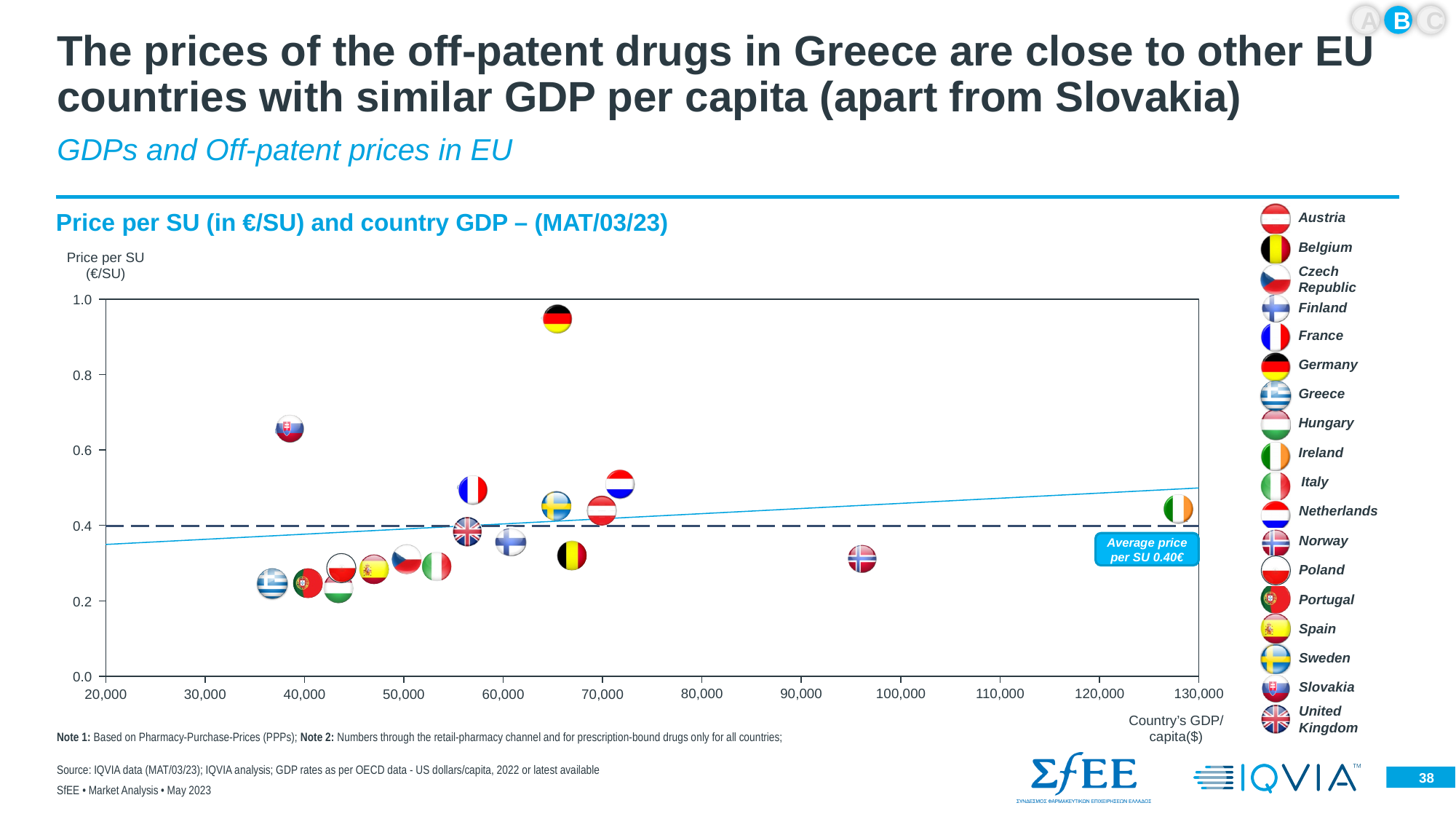
Is the price per SU for Greece greater or less than 0.4? less Is the GDP per capita for Ireland greater or less than 120,000? greater Is the price per SU for Germany greater or less than 0.8? greater What kind of chart is shown on the slide? Scatter chart Which has a higher price per SU, Slovakia or Greece? Slovakia What is the title of the chart? Price per SU (in €/SU) and country GDP – (MAT/03/23) Which country has the highest GDP per capita on the chart? Ireland How many countries are listed in the legend? 18 What is the average price per SU shown on the chart? 0.40€ Which country has the highest price per SU on the chart? Germany